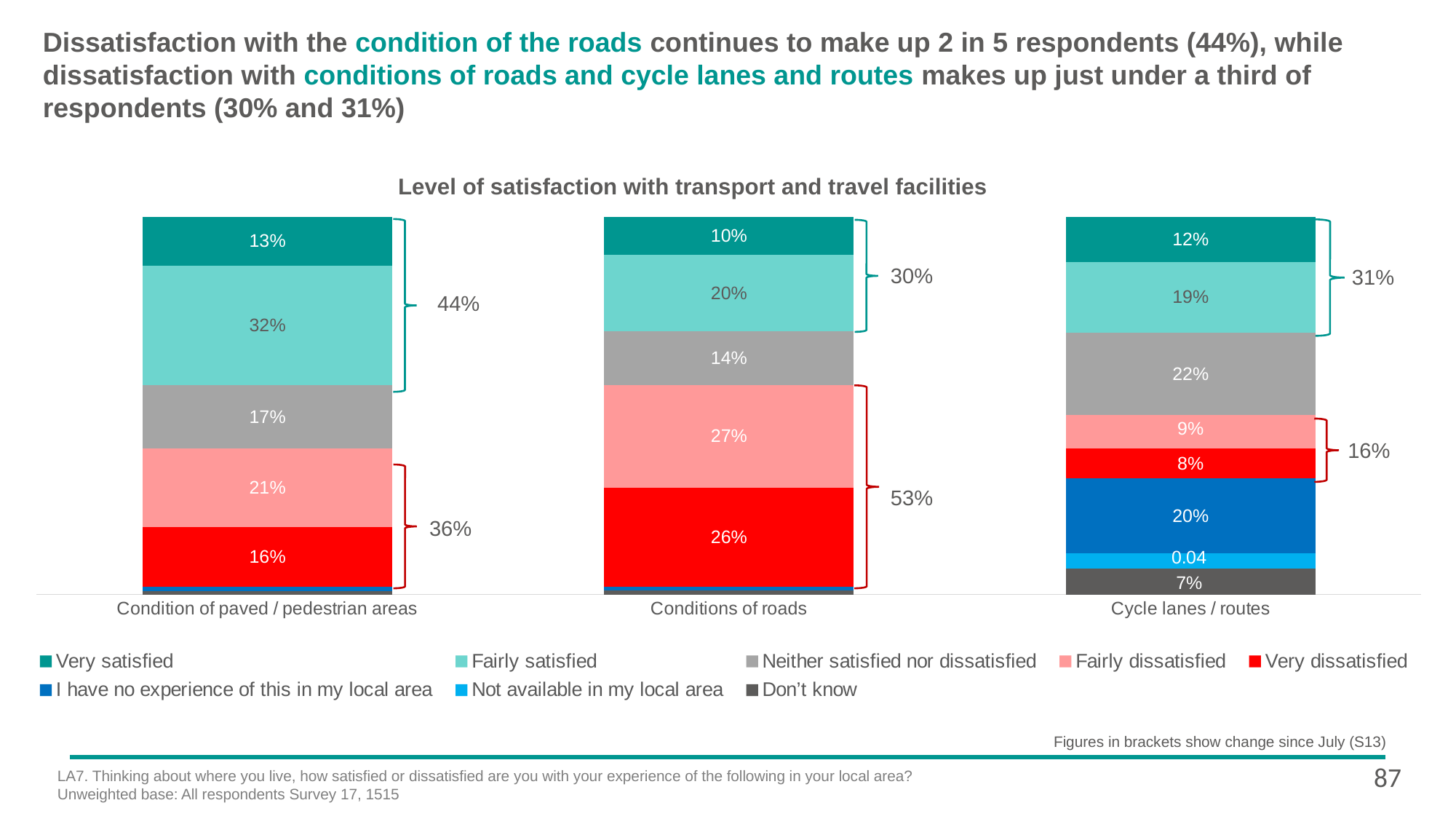
What is the 'Fairly satisfied' value for Condition of paved / pedestrian areas? 32% Which category has the lowest 'Fairly dissatisfied' value? Cycle lanes / routes What is the 'I have no experience of this in my local area' value for Cycle lanes / routes? 20% How many categories are shown on the x axis? 3 Which is larger: the 'Very satisfied' value for Condition of paved / pedestrian areas or for Conditions of roads? Condition of paved / pedestrian areas What kind of chart is shown on the slide? Stacked bar chart What is the 'Neither satisfied nor dissatisfied' value for Cycle lanes / routes? 22% How many series does the legend list? 8 What is the difference between the 'Fairly dissatisfied' values for Conditions of roads and Cycle lanes / routes? 18% Which category has the highest 'Very dissatisfied' value? Conditions of roads What is the title of the chart? Level of satisfaction with transport and travel facilities What is the 'Very dissatisfied' value for Conditions of roads? 26%